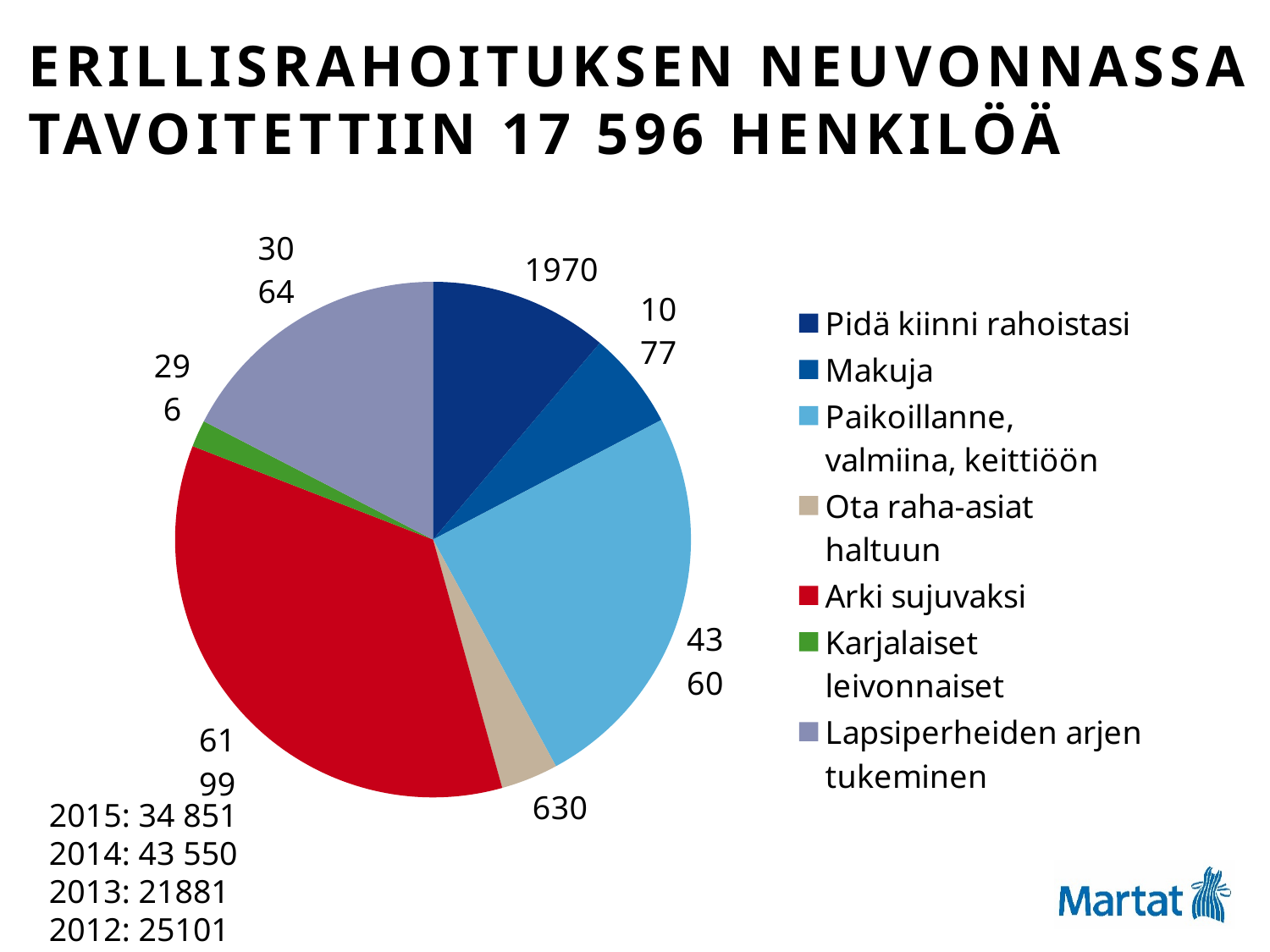
How many entries does the legend list? 7 What kind of chart is shown on the slide? pie chart What is the difference between the values for Pidä kiinni rahoistasi and Ota raha-asiat haltuun? 1340 Which is larger, the slice for Paikoillanne, valmiina, keittiöön or the slice for Pidä kiinni rahoistasi? Paikoillanne, valmiina, keittiöön Which category has the largest slice of the pie? Arki sujuvaksi What colour is the slice for Arki sujuvaksi? red How many slices does the pie chart have? 7 What is the value for Ota raha-asiat haltuun? 630 Which is larger, the slice for Lapsiperheiden arjen tukeminen or the slice for Makuja? Lapsiperheiden arjen tukeminen What is the value for Pidä kiinni rahoistasi? 1970 According to the slide title, how many people were reached in total? 17 596 Which category has the smallest slice of the pie? Karjalaiset leivonnaiset